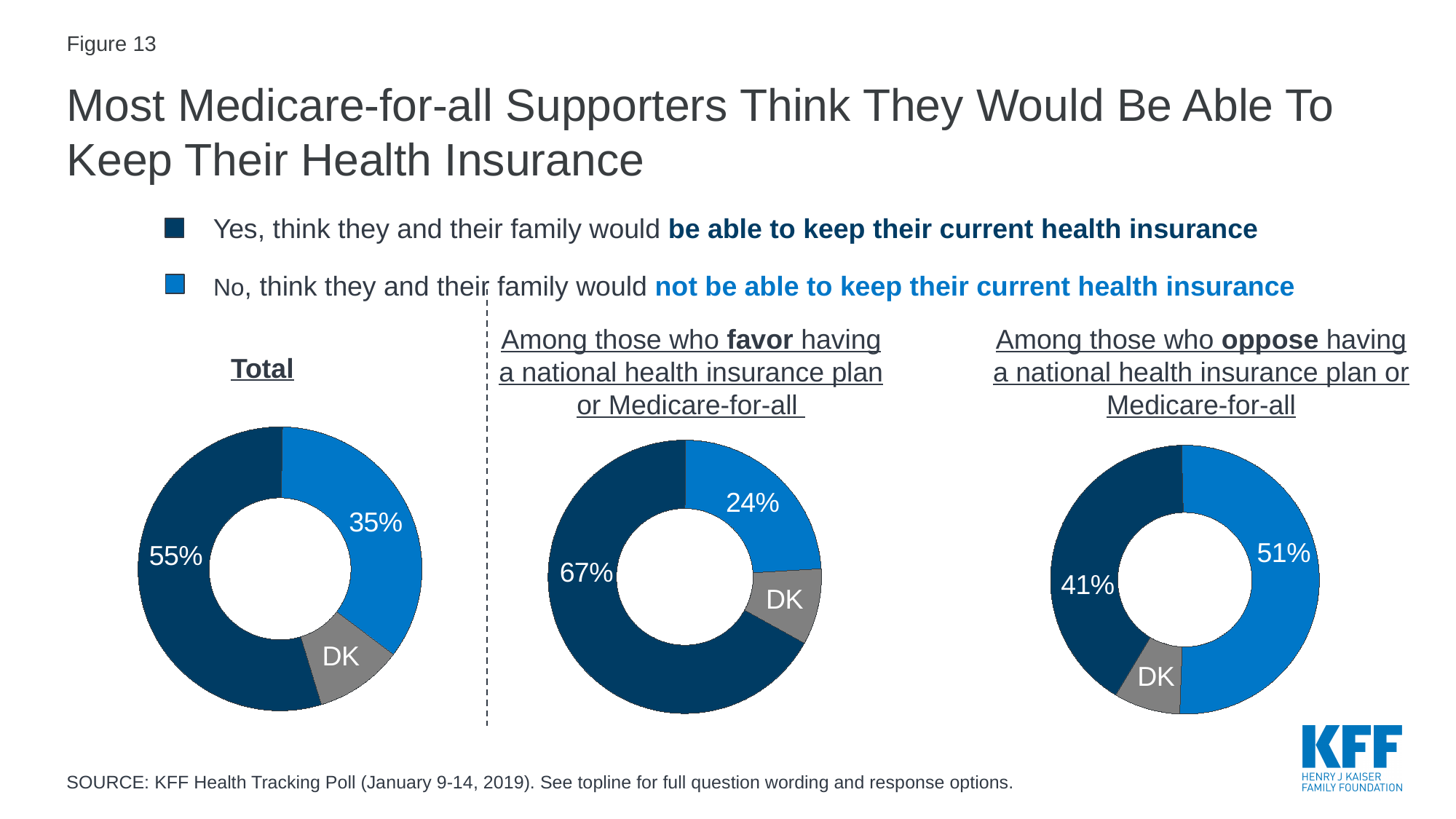
In the chart for those who favor Medicare-for-all, what is the difference between the 'Yes' share and the 'No' share? 43 percentage points In the chart for those who oppose Medicare-for-all, which is larger: the share who think they would be able to keep their insurance or the share who think they would not? Not be able to keep (51%) In the chart for those who oppose a national health insurance plan or Medicare-for-all, what share think they would not be able to keep their current health insurance? 51% In the Total chart, what is the difference between the share who think they would be able to keep their insurance and the share who think they would not? 20 percentage points In the chart for those who oppose a national health insurance plan or Medicare-for-all, what share think they would be able to keep their current health insurance? 41% How many charts are shown on the slide? 3 In the Total chart, what share think they would be able to keep their current health insurance? 55% In the chart for those who favor a national health insurance plan or Medicare-for-all, what share think they would not be able to keep their current health insurance? 24% In the Total chart, what share think they would not be able to keep their current health insurance? 35% How many response categories does the legend at the top of the slide list? 2 What kind of chart is used on this slide? Donut (pie) chart In the chart for those who favor a national health insurance plan or Medicare-for-all, what share think they would be able to keep their current health insurance? 67%